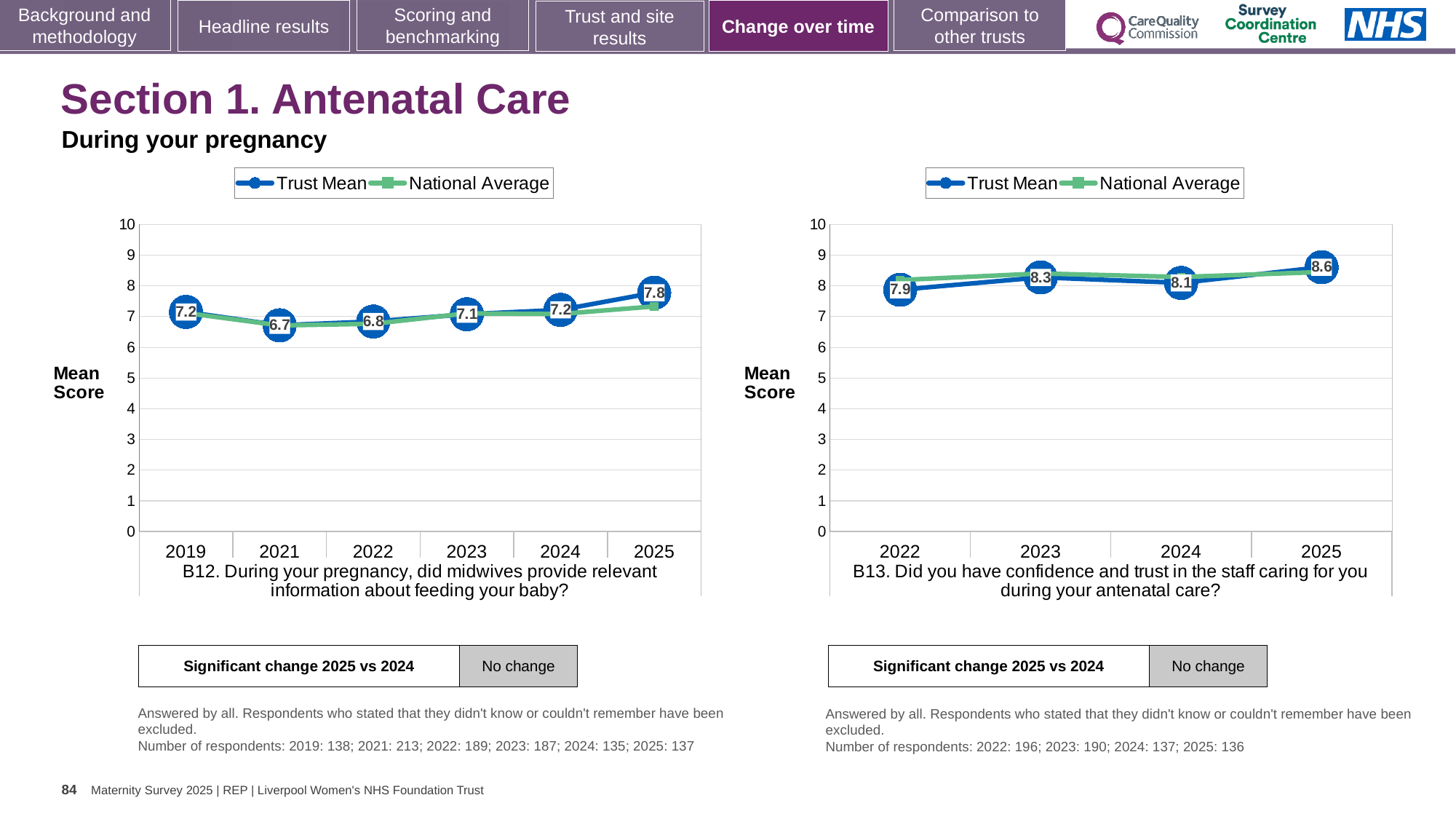
In the B13 chart (right), what is the Trust Mean score for 2023? 8.3 In the B12 chart (left), is the National Average value for 2025 greater or less than 7? greater In the B13 chart (right), which year has the highest Trust Mean score? 2025 In the B13 chart (right), is the Trust Mean score higher in 2023 or in 2024? 2023 How many series does the legend of the B13 chart (right) list? 2 In the B12 chart (left), what is the Trust Mean score for 2021? 6.7 In the B12 chart (left), which year has the lowest Trust Mean score? 2021 How many years are shown on the x axis of the B12 chart (left)? 6 What type of chart is used for B13 (right)? Line chart In the B12 chart (left), what is the Trust Mean score for 2025? 7.8 In the B12 chart (left), what is the difference between the Trust Mean scores for 2025 and 2024? 0.6 In the B13 chart (right), what is the difference between the Trust Mean scores for 2025 and 2022? 0.7